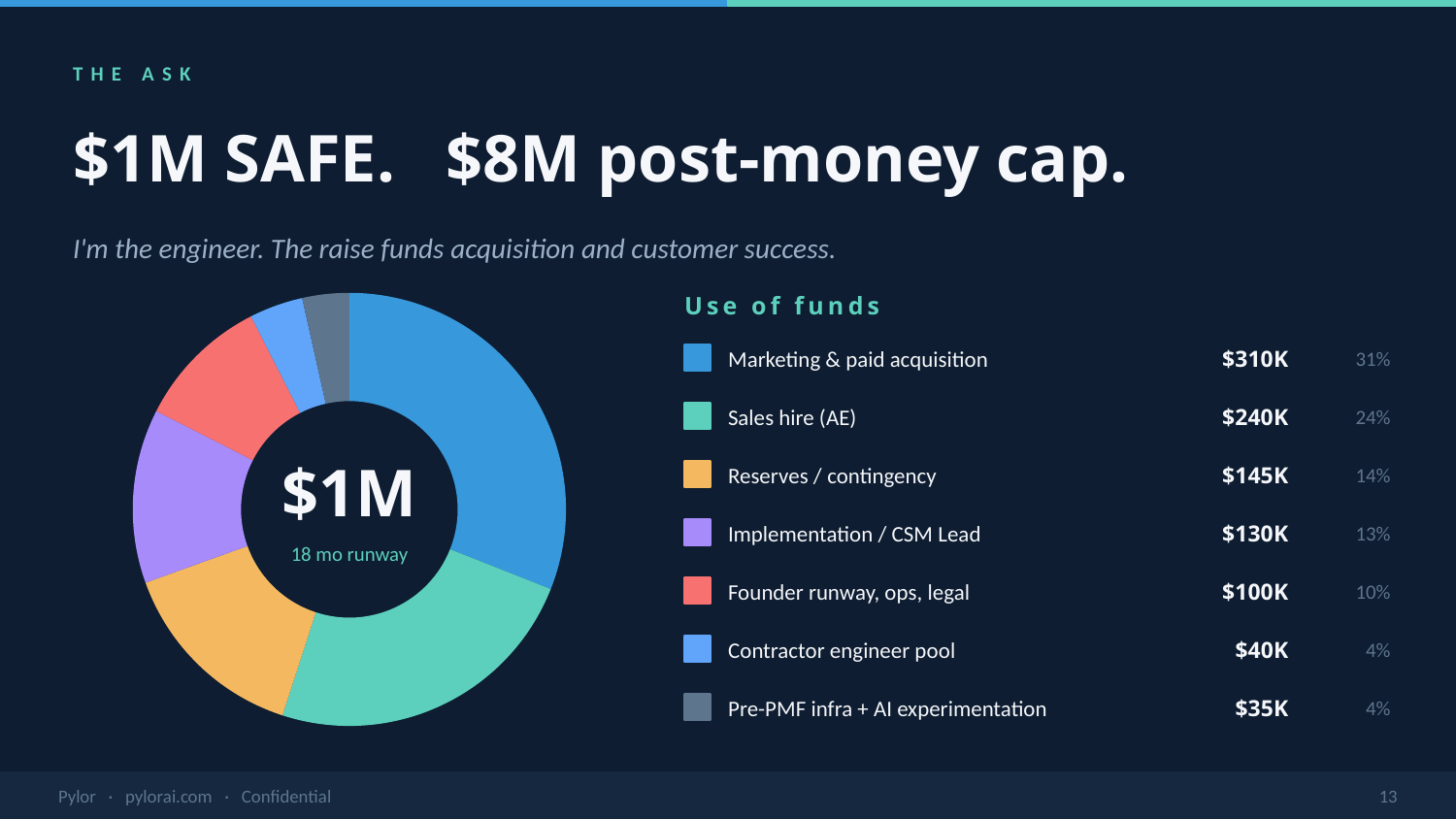
What percentage share of the funds goes to Founder runway, ops, legal? 10% What percentage share of the funds goes to Sales hire (AE)? 24% What is the difference between the Marketing & paid acquisition amount and the Sales hire (AE) amount? $70K What amount is allocated to Implementation / CSM Lead? $130K What is the title of the legend next to the donut chart? Use of funds Which category receives the smallest amount of funds? Pre-PMF infra + AI experimentation Which category receives the largest share of funds? Marketing & paid acquisition Which is larger: Reserves / contingency or Implementation / CSM Lead? Reserves / contingency What amount is allocated to Marketing & paid acquisition? $310K What total amount is shown in the centre of the donut chart? $1M What kind of chart is shown on the slide? Pie chart (donut) How many categories does the Use of funds chart break the $1M into? 7